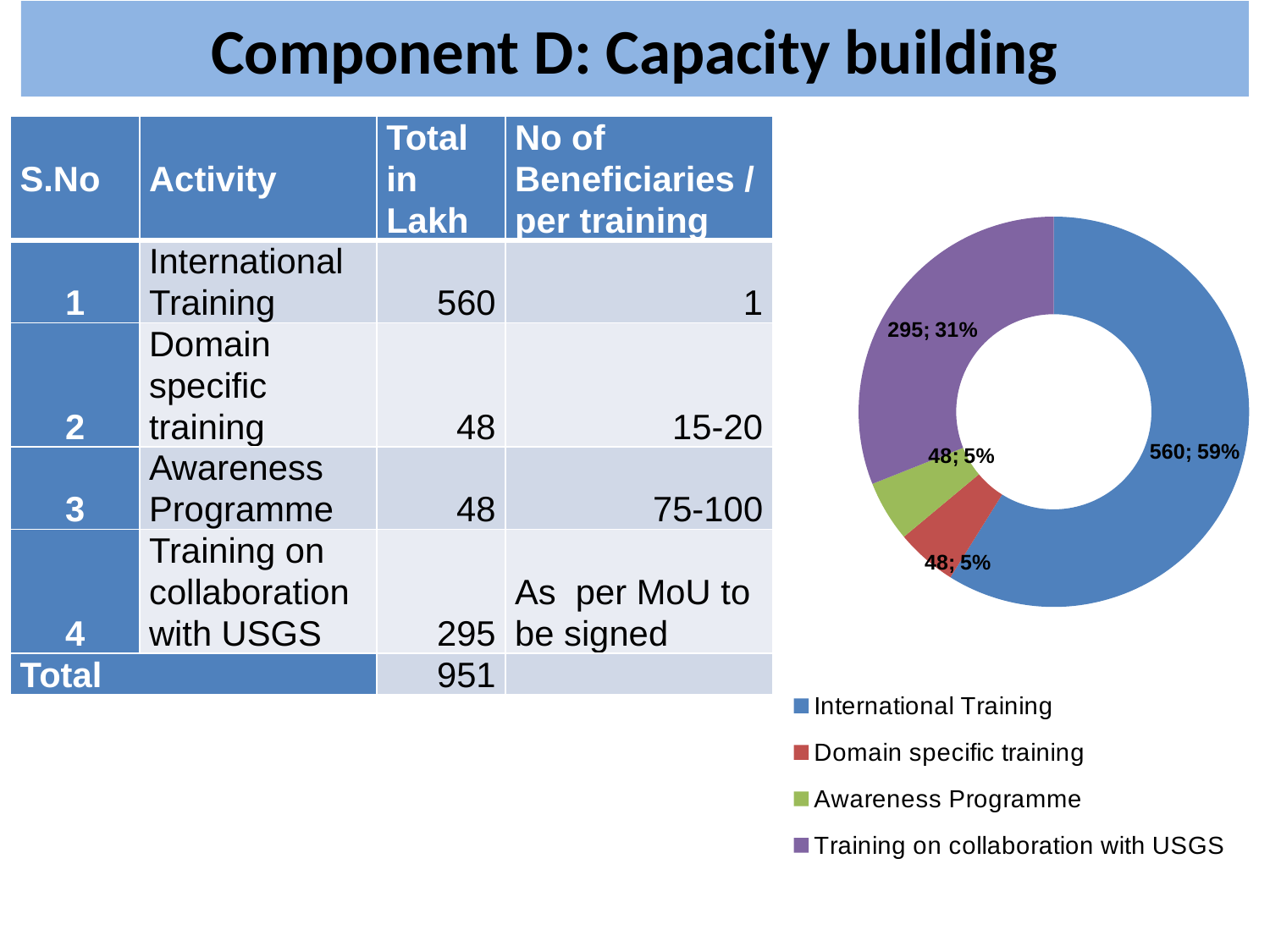
Which category has the largest slice in the chart? International Training What value is shown for Training on collaboration with USGS in the chart? 295 What is the difference between the values for International Training and Training on collaboration with USGS? 265 Which is larger in the chart, International Training or Training on collaboration with USGS? International Training What percentage share does International Training have in the chart? 59% How many slices does the doughnut chart have? 4 Which colour represents Awareness Programme in the chart? Green What kind of chart is shown on the slide? Doughnut chart What percentage share does Awareness Programme have in the chart? 5% How many entries does the chart legend list? 4 What percentage share does Training on collaboration with USGS have in the chart? 31% What value is shown for International Training in the chart? 560